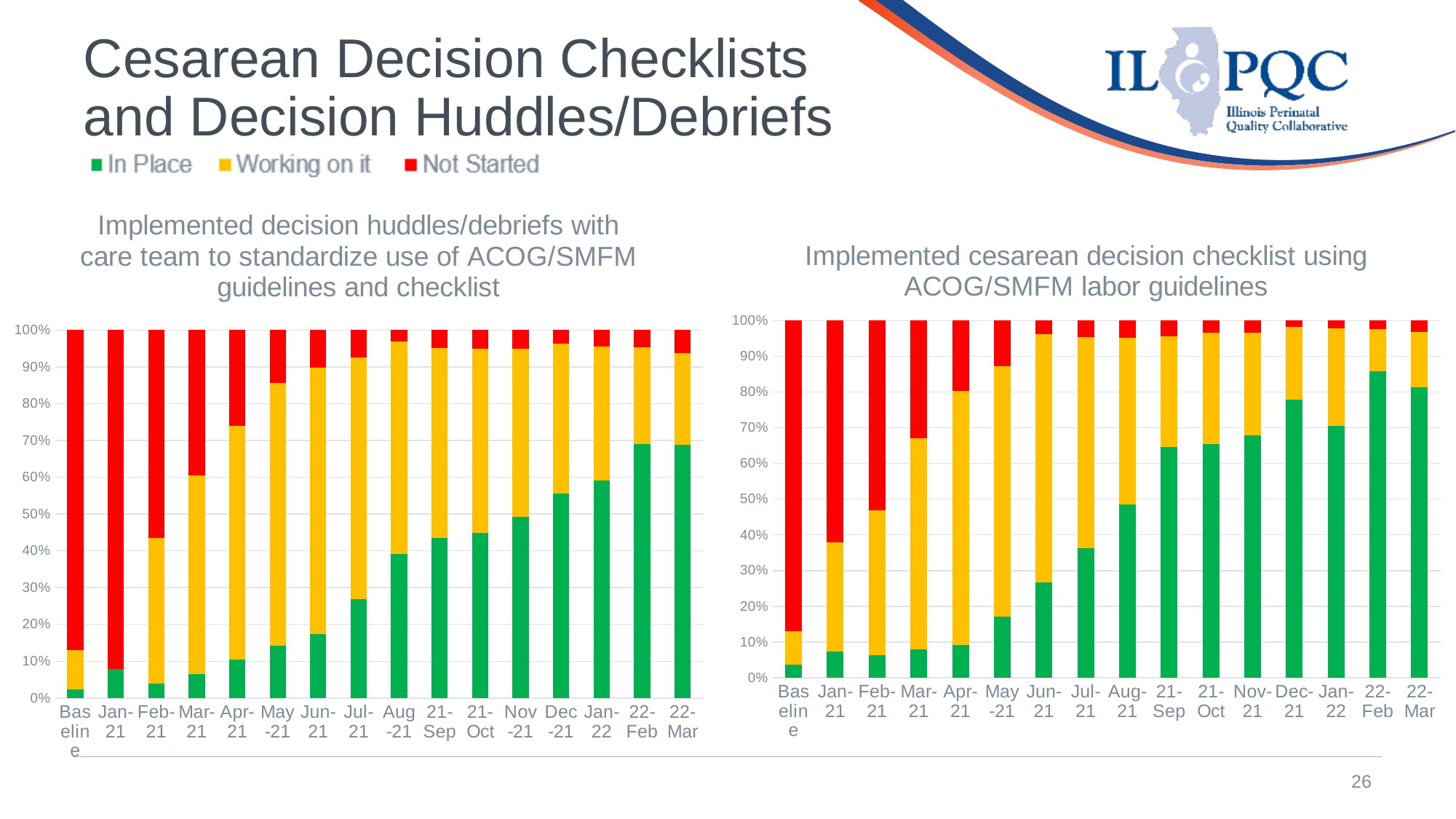
In the left chart, 'Implemented decision huddles/debriefs', is the 'In Place' value for Jul-21 greater or less than 30%? less How many series does the legend list for the charts on this slide? 3 In the right chart, 'Implemented cesarean decision checklist', does the 'In Place' share generally rise or fall from Baseline to 22-Mar? rise In the right chart, 'Implemented cesarean decision checklist', which has the larger 'In Place' share, Dec-21 or Jan-22? Dec-21 In the right chart, 'Implemented cesarean decision checklist', is the 'In Place' value for Aug-21 greater or less than 50%? less Which colour represents 'Not Started' in the legend? Red In the left chart, 'Implemented decision huddles/debriefs', is the 'In Place' value for Dec-21 greater or less than 50%? greater In the right chart, 'Implemented cesarean decision checklist', which period has the highest 'In Place' share? 22-Feb In the left chart, 'Implemented decision huddles/debriefs', what is the total height of each stacked bar? 100% In the right chart, 'Implemented cesarean decision checklist using ACOG/SMFM labor guidelines', how many time-period categories are shown on the x axis? 16 What kind of chart is the left chart, 'Implemented decision huddles/debriefs with care team to standardize use of ACOG/SMFM guidelines and checklist'? Stacked bar chart